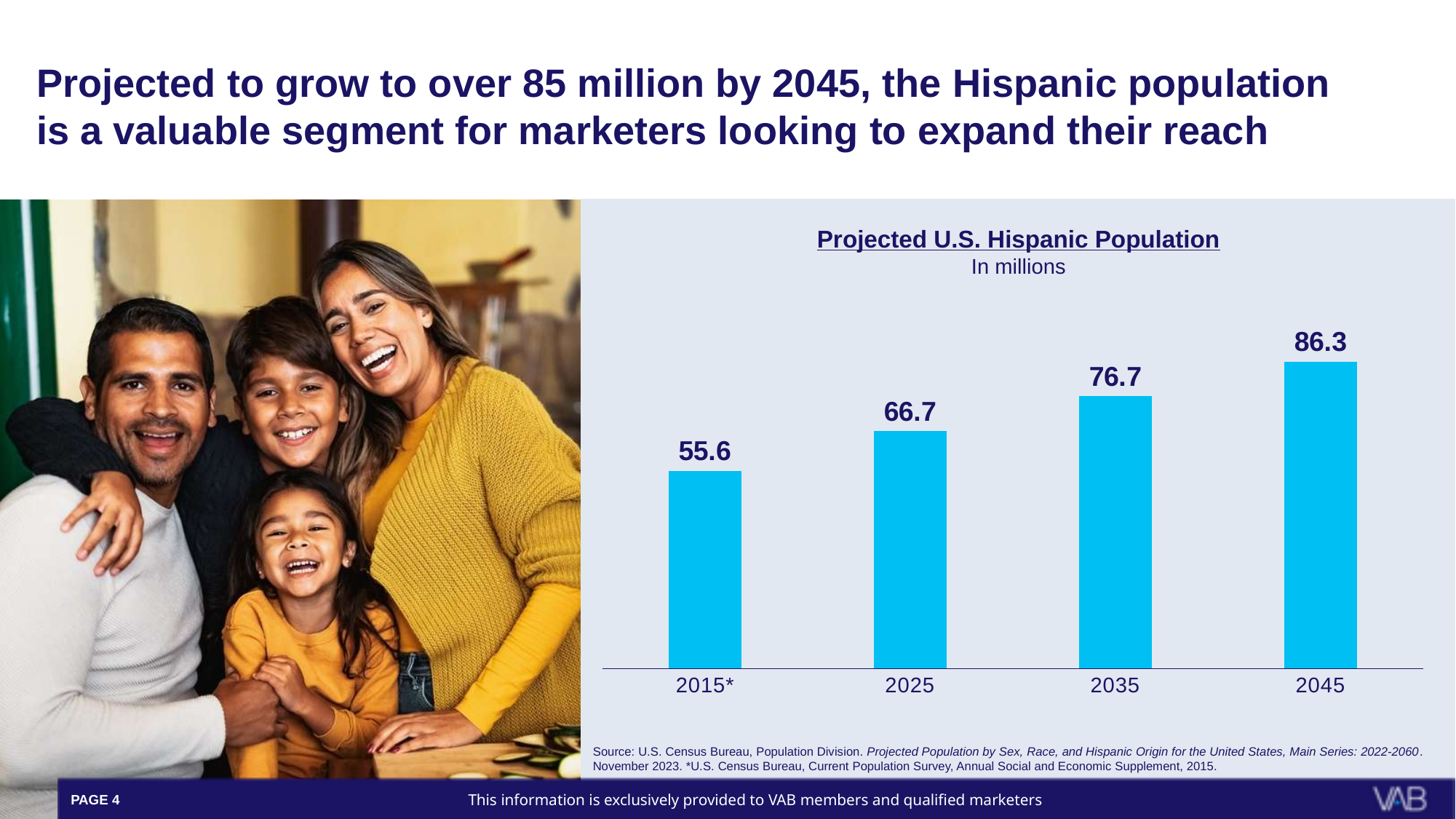
What is the projected U.S. Hispanic population for 2045? 86.3 Which is larger, the value for 2035 or the value for 2025? 2035 Which year has the lowest value in the Projected U.S. Hispanic Population chart? 2015* Which year has the highest projected U.S. Hispanic population? 2045 What is the projected U.S. Hispanic population for 2025? 66.7 In what units are the values in the Projected U.S. Hispanic Population chart expressed? In millions What is the difference between the 2035 and 2025 values in the Projected U.S. Hispanic Population chart? 10.0 How many years are shown in the Projected U.S. Hispanic Population chart? 4 Do the values in the Projected U.S. Hispanic Population chart rise or fall from 2015* to 2045? Rise What is the difference between the 2045 and 2015* values in the Projected U.S. Hispanic Population chart? 30.7 What kind of chart is used to show the Projected U.S. Hispanic Population? Bar chart What value is shown for 2015* in the Projected U.S. Hispanic Population chart? 55.6